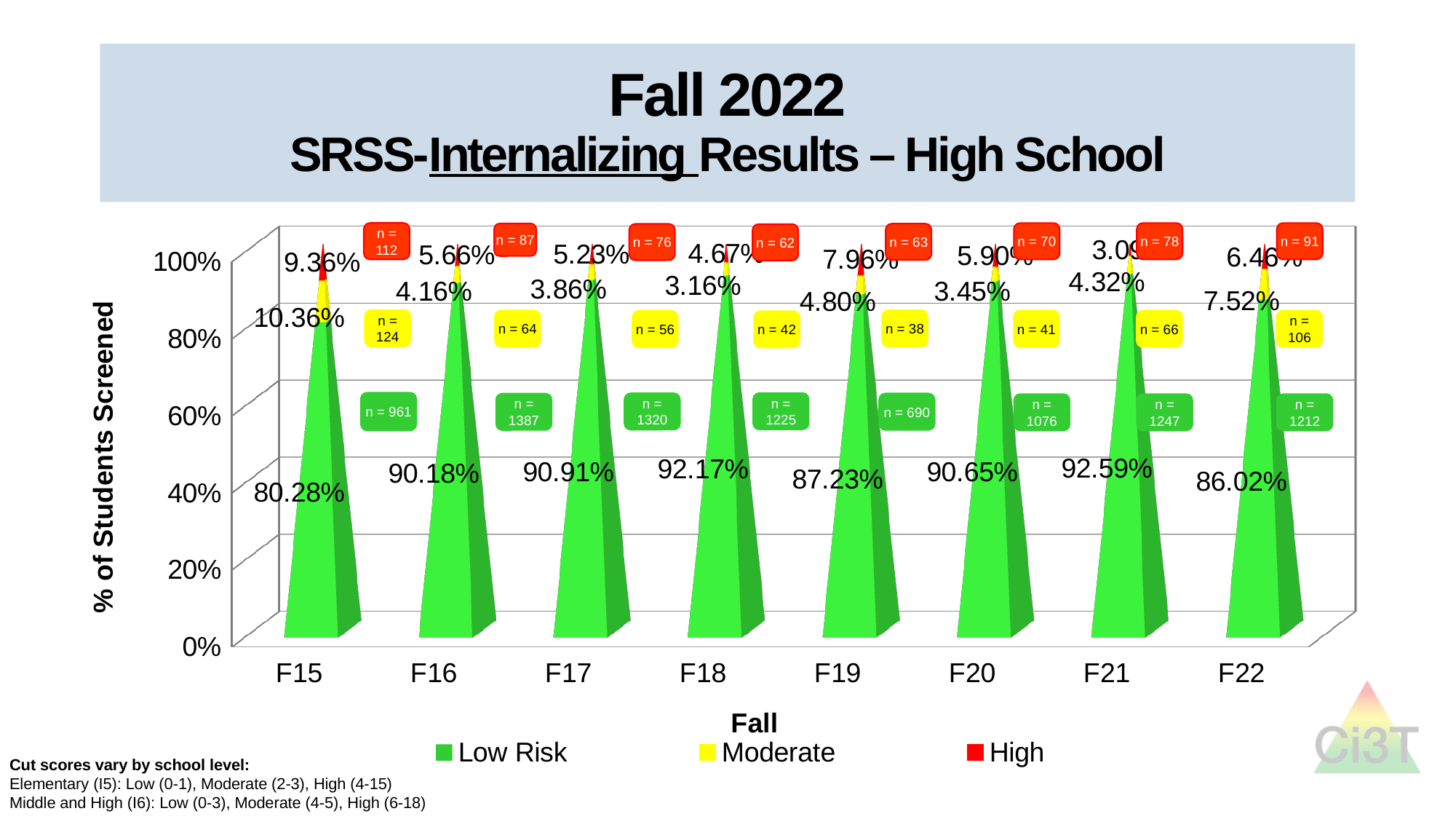
How many series does the legend list? 3 What is the difference between the Low Risk percentage in F21 and in F15? 12.31 percentage points Is the Low Risk percentage higher in F18 or in F19? F18 Which fall has the highest Low Risk percentage? F21 What percentage of students screened were Low Risk in F15? 80.28% Is the Low Risk value for F22 greater or less than 80%? greater What is the n (number of students) for the Low Risk group in F16? 1387 Which fall has the lowest Low Risk percentage? F15 How many fall screening periods are shown on the x axis? 8 What is the Moderate percentage for F22? 7.52% Which fall has the highest Moderate percentage? F15 What is the High percentage for F19? 7.96%